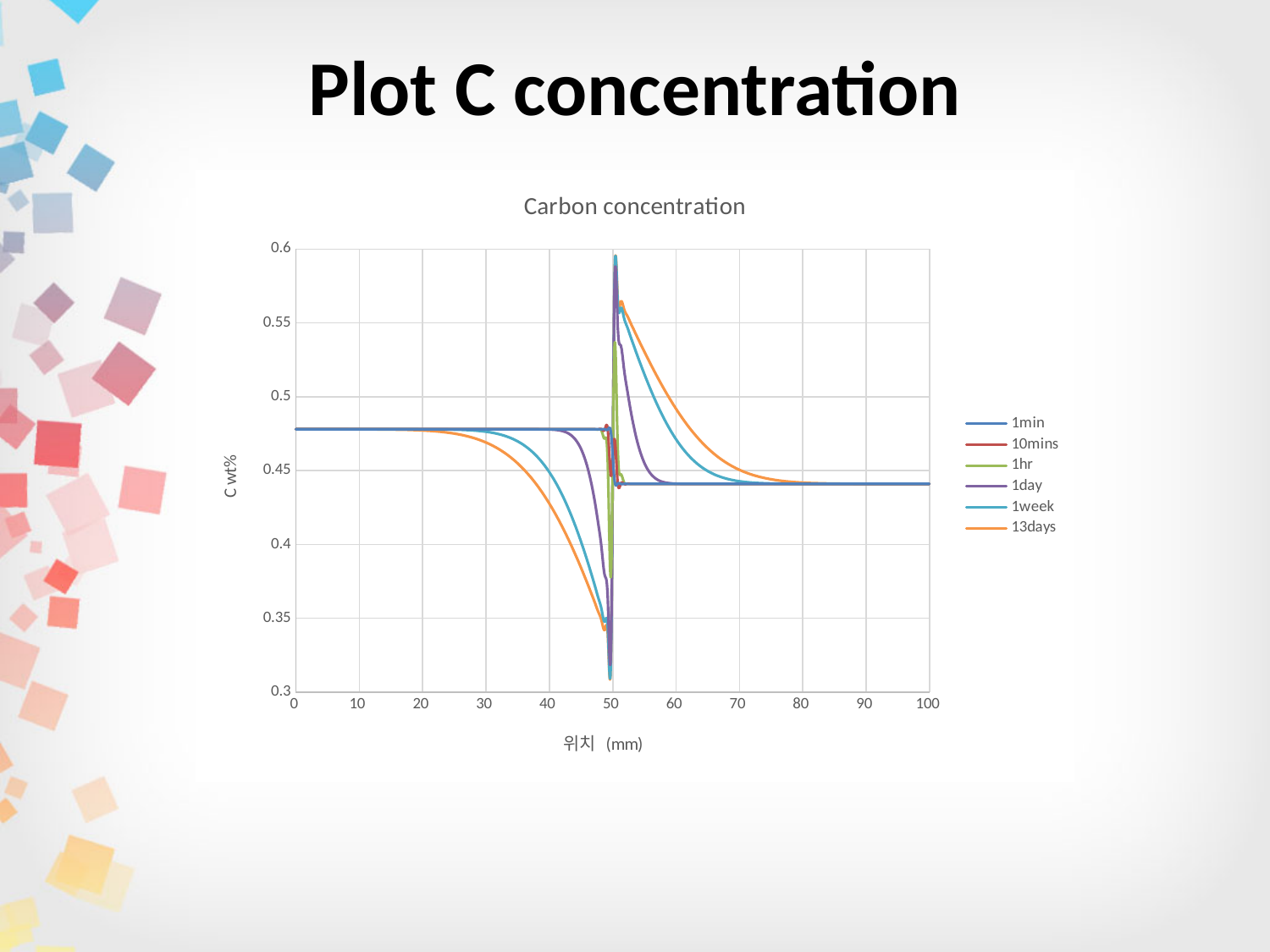
How many series does the legend of the Carbon concentration chart list? 6 What is the label of the y axis of the Carbon concentration chart? C wt% Is the value of the 1week series at x = 70 greater or less than 0.5? less What kind of chart is shown on the slide? Line chart Is the value of the 1week series at x = 30 greater or less than 0.45? greater At x = 60, which series has the larger value, 13days or 1day? 13days Is the value of the 1min series at x = 0 greater or less than 0.45? greater What is the title of the chart on the slide? Carbon concentration At x = 40, which series has the larger value, 1day or 13days? 1day